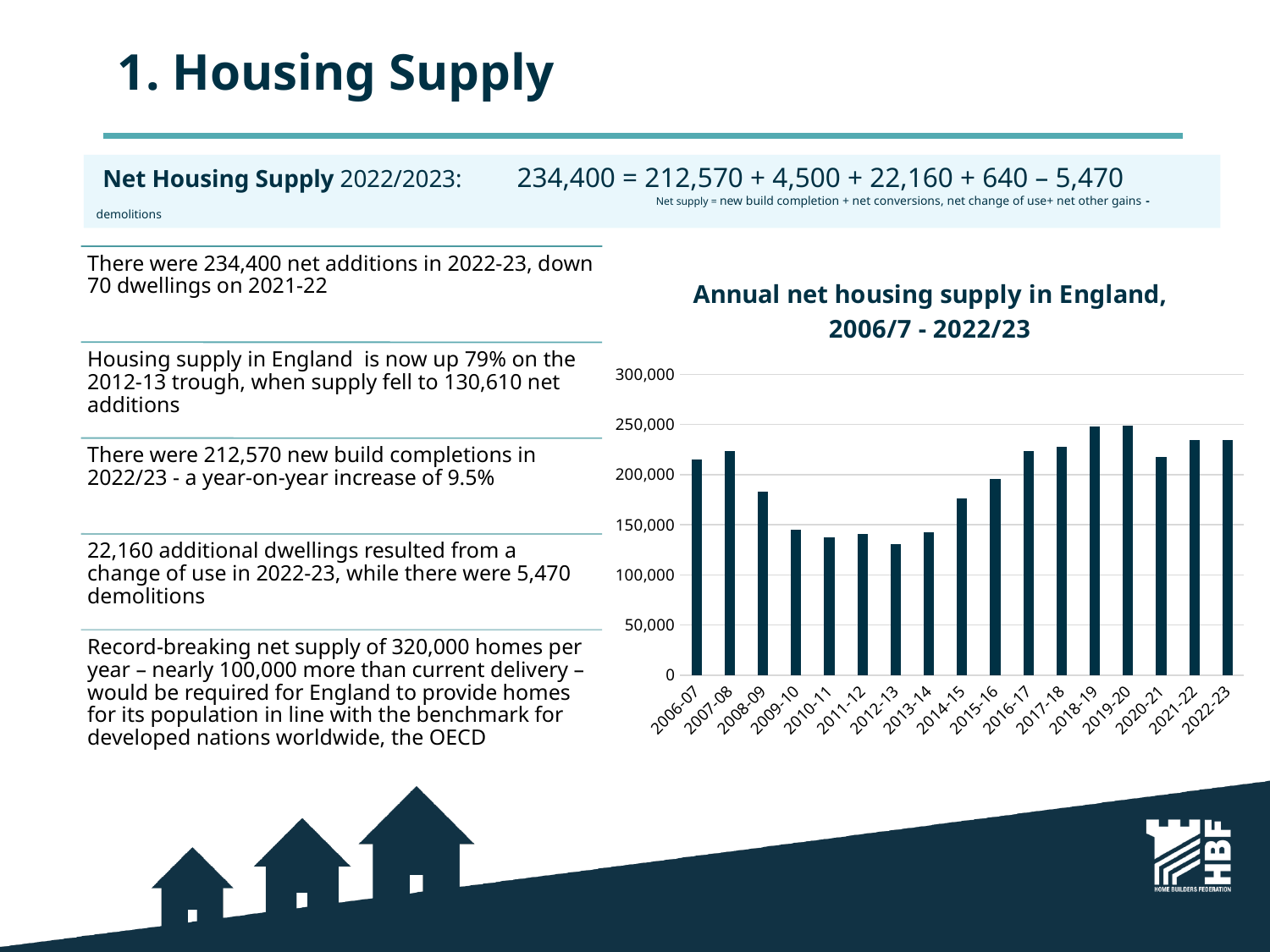
Is the value for 2006-07 greater or less than 200,000? greater Do the values rise or fall from 2012-13 to 2018-19? rise Which is larger, the value for 2008-09 or the value for 2009-10? 2008-09 What is the title of the chart? Annual net housing supply in England, 2006/7 - 2022/23 Which is larger, the value for 2020-21 or the value for 2021-22? 2021-22 How many years (bars) are plotted in the chart? 17 Is the value for 2012-13 greater or less than 150,000? less What is the highest value shown on the chart's vertical axis? 300,000 What kind of chart is shown on the slide? bar chart Which year has the lowest annual net housing supply in the chart? 2012-13 Is the value for 2018-19 greater or less than 200,000? greater